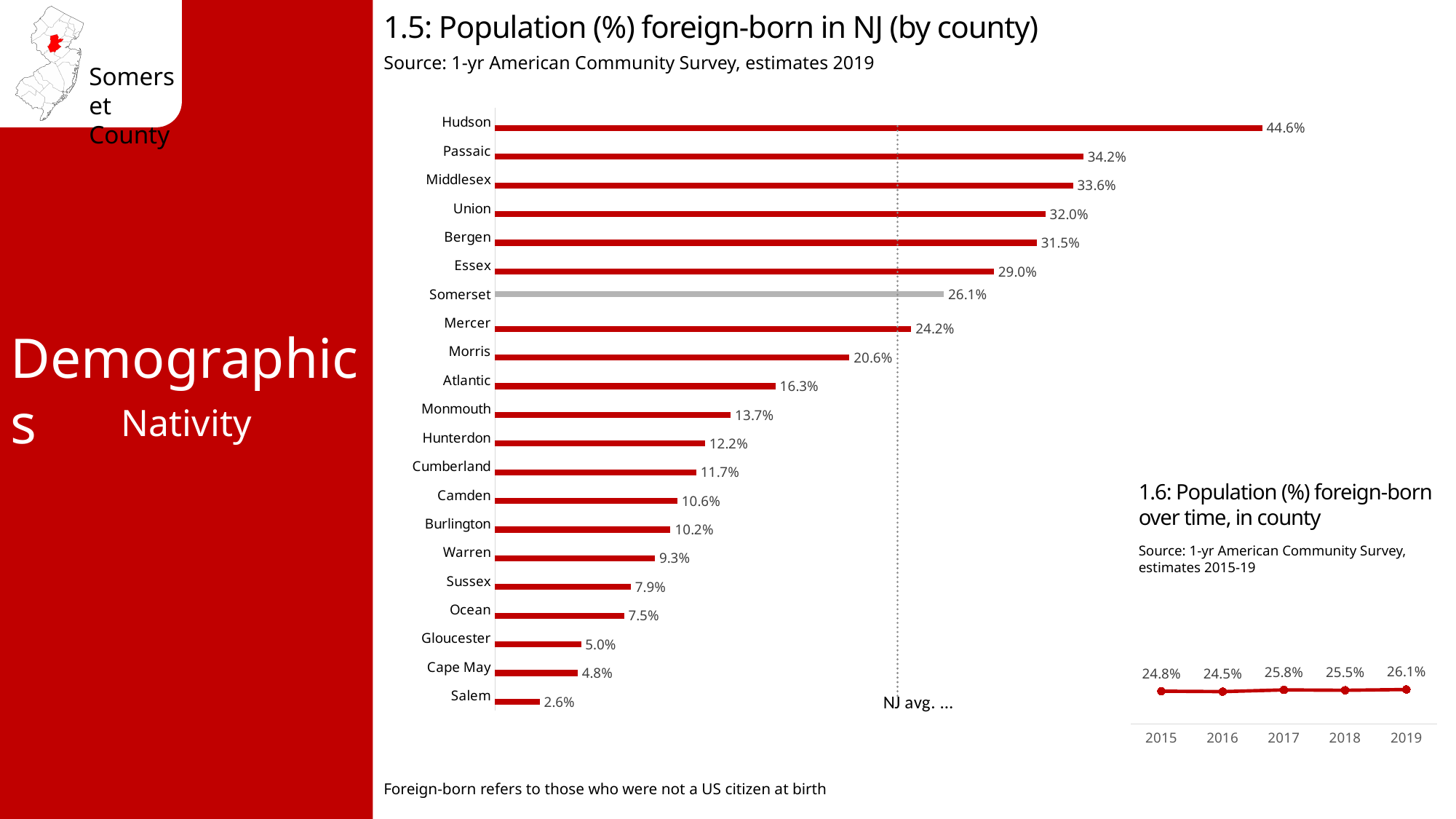
In chart 1.6 (Population (%) foreign-born over time, in county), what is the value for 2017? 25.8% What kind of chart is chart 1.5 (Population (%) foreign-born in NJ by county)? Bar chart In chart 1.5 (Population (%) foreign-born in NJ by county), which county has the highest value? Hudson In chart 1.5 (Population (%) foreign-born in NJ by county), which is larger, Mercer or Morris? Mercer In chart 1.5 (Population (%) foreign-born in NJ by county), how many counties are shown? 21 In chart 1.5 (Population (%) foreign-born in NJ by county), which county's bar is coloured grey instead of red? Somerset In chart 1.5 (Population (%) foreign-born in NJ by county), which county has the lowest value? Salem In chart 1.5 (Population (%) foreign-born in NJ by county), what is the value for Somerset? 26.1% In chart 1.5 (Population (%) foreign-born in NJ by county), what is the value for Hudson? 44.6% In chart 1.5 (Population (%) foreign-born in NJ by county), what is the difference between Passaic and Middlesex? 0.6% In chart 1.6 (Population (%) foreign-born over time, in county), which year has the lowest value? 2016 In chart 1.6 (Population (%) foreign-born over time, in county), what is the difference between 2019 and 2015? 1.3%